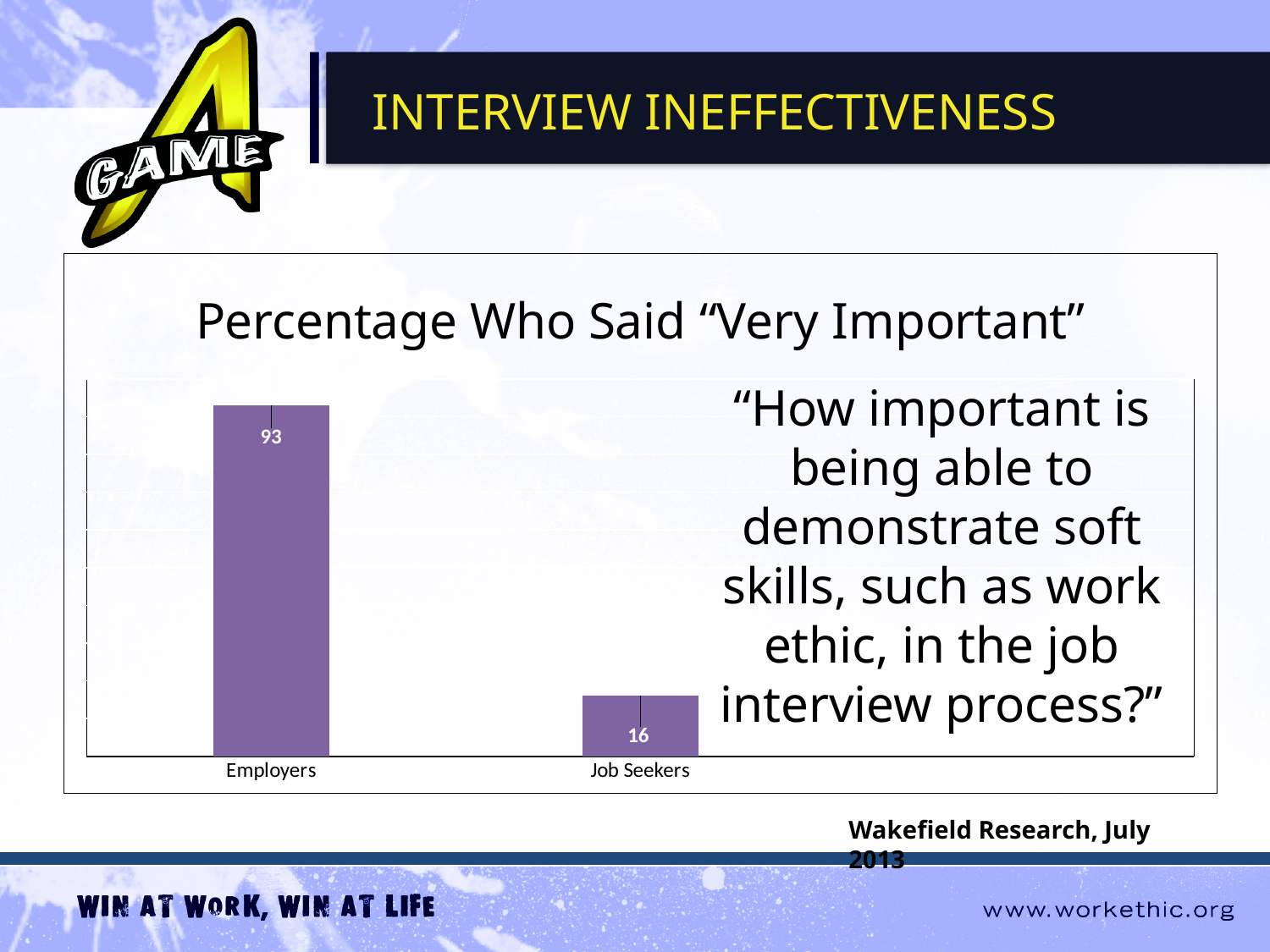
What is the value for Job Seekers? 16 How many categories are shown in the chart? 2 Which is larger, the value for Employers or the value for Job Seekers? Employers Which category has the lowest value? Job Seekers What is the value for Employers? 93 What is the difference between the values for Employers and Job Seekers? 77 Which category has the highest value? Employers What is the title of the chart? Percentage Who Said "Very Important" What colour are the bars in the chart? Purple What kind of chart is shown on the slide? Bar chart